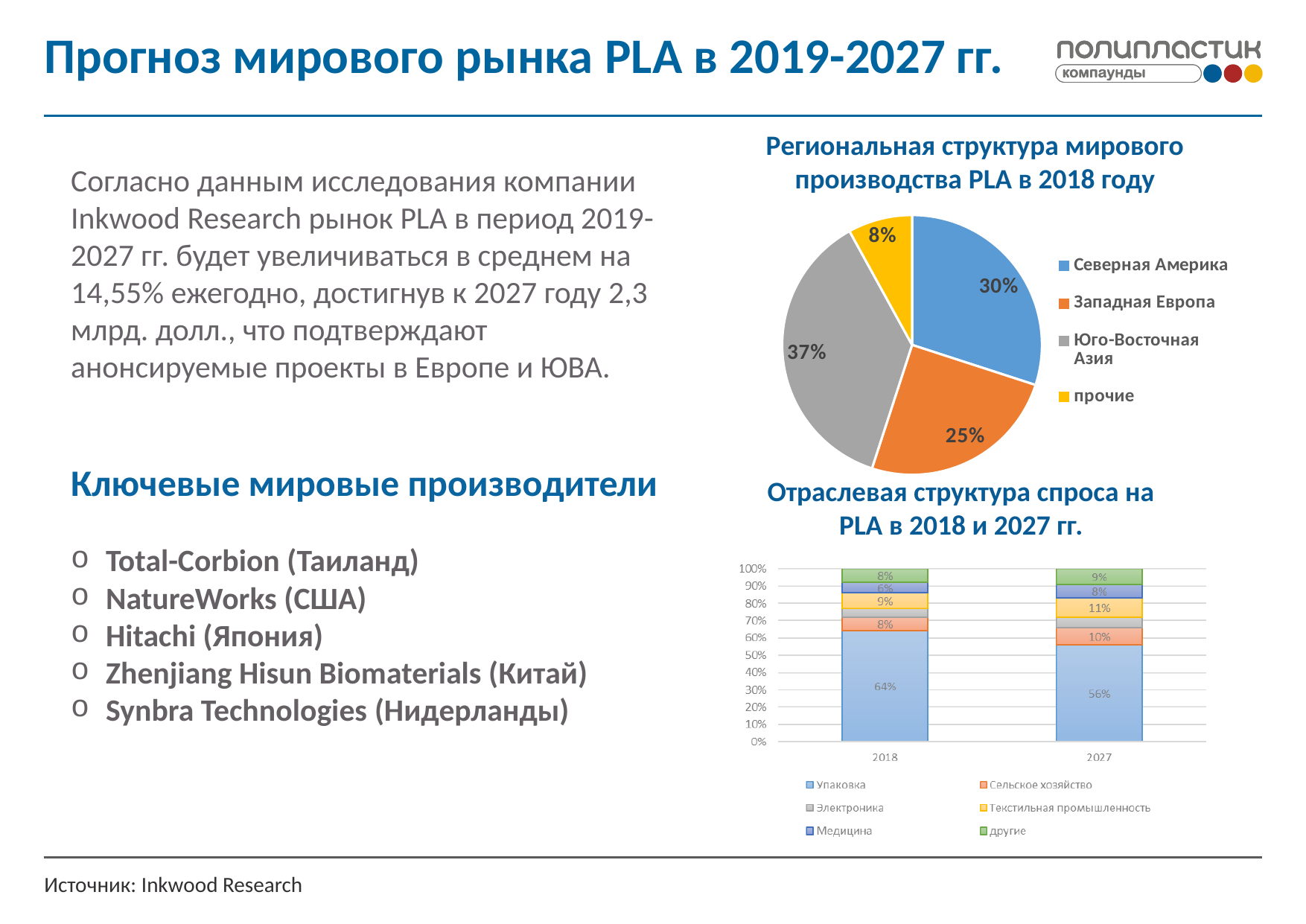
In the chart 'Отраслевая структура спроса на PLA в 2018 и 2027 гг.', how many series does the legend list? 6 In the pie chart 'Региональная структура мирового производства PLA в 2018 году', which region has the largest share? Юго-Восточная Азия In the pie chart 'Региональная структура мирового производства PLA в 2018 году', what share does Юго-Восточная Азия have? 37% In the chart 'Отраслевая структура спроса на PLA в 2018 и 2027 гг.', what is the value for Упаковка in 2018? 64% In the chart 'Отраслевая структура спроса на PLA в 2018 и 2027 гг.', is the share of Упаковка larger in 2018 or in 2027? 2018 In the pie chart 'Региональная структура мирового производства PLA в 2018 году', how many categories does the legend list? 4 In the pie chart 'Региональная структура мирового производства PLA в 2018 году', what share does Северная Америка have? 30% In the pie chart 'Региональная структура мирового производства PLA в 2018 году', what is the difference between the shares of Северная Америка and Западная Европа? 5% What kind of chart is 'Отраслевая структура спроса на PLA в 2018 и 2027 гг.'? Stacked bar chart In the chart 'Отраслевая структура спроса на PLA в 2018 и 2027 гг.', what is the value for Текстильная промышленность in 2027? 11% In the pie chart 'Региональная структура мирового производства PLA в 2018 году', which category has the smallest share? прочие In the chart 'Отраслевая структура спроса на PLA в 2018 и 2027 гг.', what is the value for Упаковка in 2027? 56%